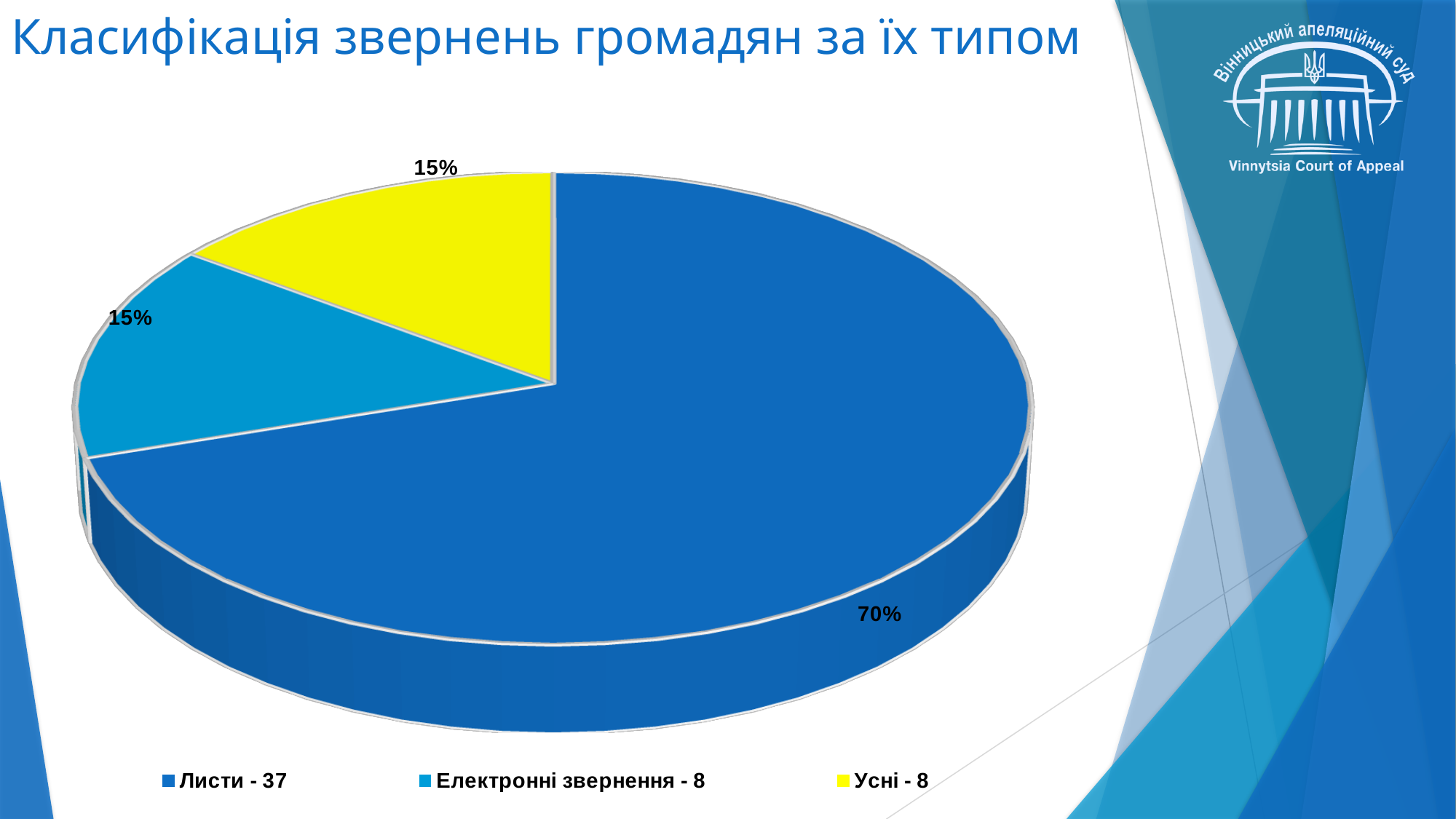
According to the legend, how many more Листи are there than Усні? 29 How many slices does the pie chart have? 3 What share of the pie does the Електронні звернення slice represent? 15% What is the difference in percentage points between the Листи slice and the Усні slice? 55% What share of the pie does the Листи slice represent? 70% Which category has the largest slice of the pie? Листи Which slice is larger, Листи or Електронні звернення? Листи What is the title of the slide? Класифікація звернень громадян за їх типом What share of the pie does the Усні slice represent? 15% What kind of chart is shown on the slide? Pie chart According to the legend, how many Листи are there? 37 What colour is the Усні slice? Yellow